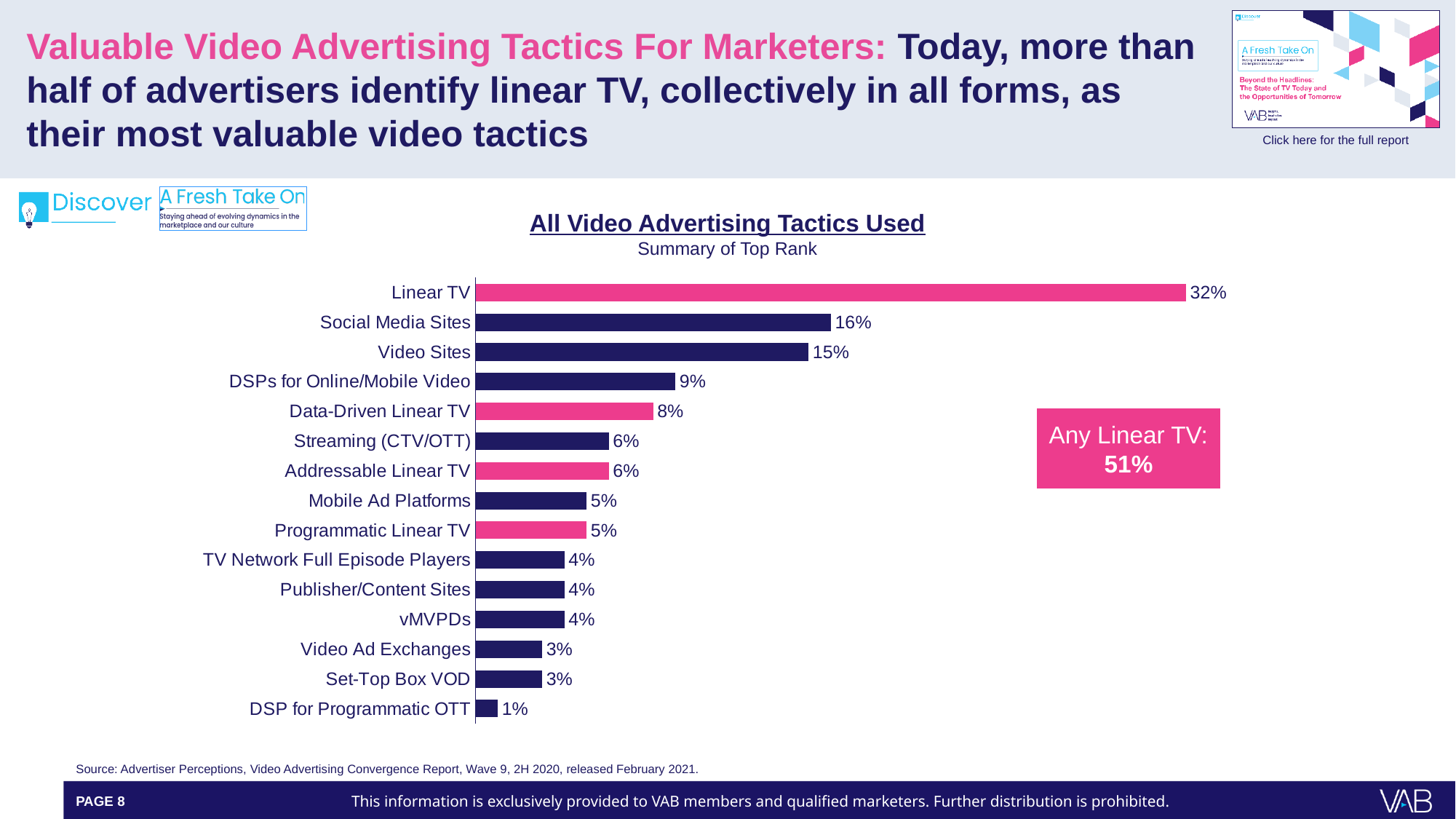
What is the title of the chart? All Video Advertising Tactics Used Which category has the lowest value? DSP for Programmatic OTT What is the difference between the values for Video Sites and Data-Driven Linear TV? 7% Which category has the highest value? Linear TV What is the value for Linear TV? 32% What is the value for DSP for Programmatic OTT? 1% What is the value for Social Media Sites? 16% Which is larger, the value for Streaming (CTV/OTT) or the value for Video Ad Exchanges? Streaming (CTV/OTT) What is the difference between the values for Linear TV and Social Media Sites? 16% What is the value for DSPs for Online/Mobile Video? 9% How many categories are shown in the chart? 15 What kind of chart is shown on the slide? Bar chart